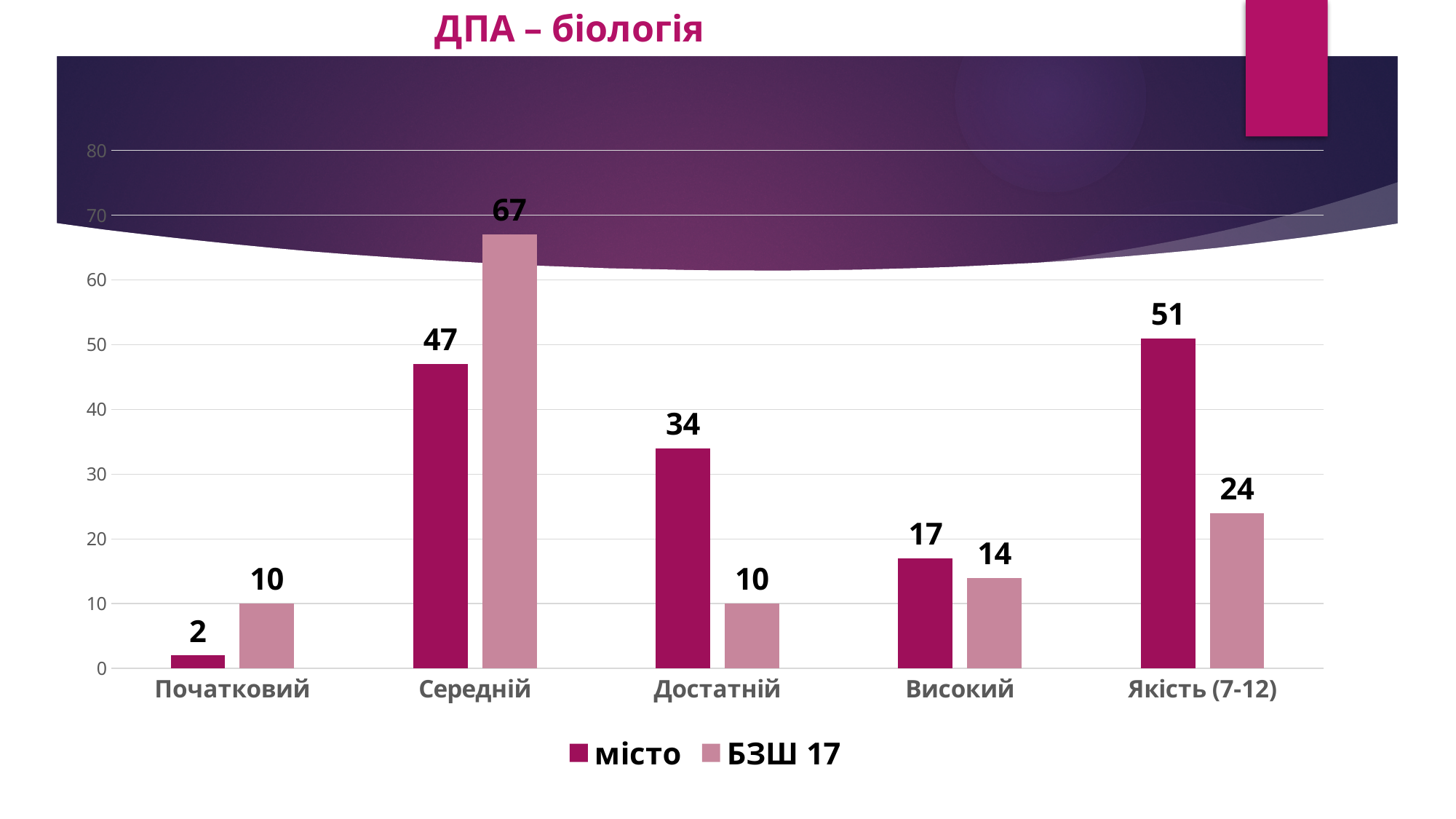
What is the value for місто in the Середній category? 47 Which category has the lowest value for місто? Початковий What is the difference between місто and БЗШ 17 in the Достатній category? 24 Which category has the highest value for БЗШ 17? Середній What kind of chart is shown on the slide? bar chart What is the value for місто in the Початковий category? 2 How many series does the legend list? 2 What is the difference between БЗШ 17 and місто in the Середній category? 20 What is the title of the chart? ДПА – біологія How many categories are shown on the x axis? 5 What is the value for БЗШ 17 in the Якість (7-12) category? 24 Which is larger in the Високий category, місто or БЗШ 17? місто